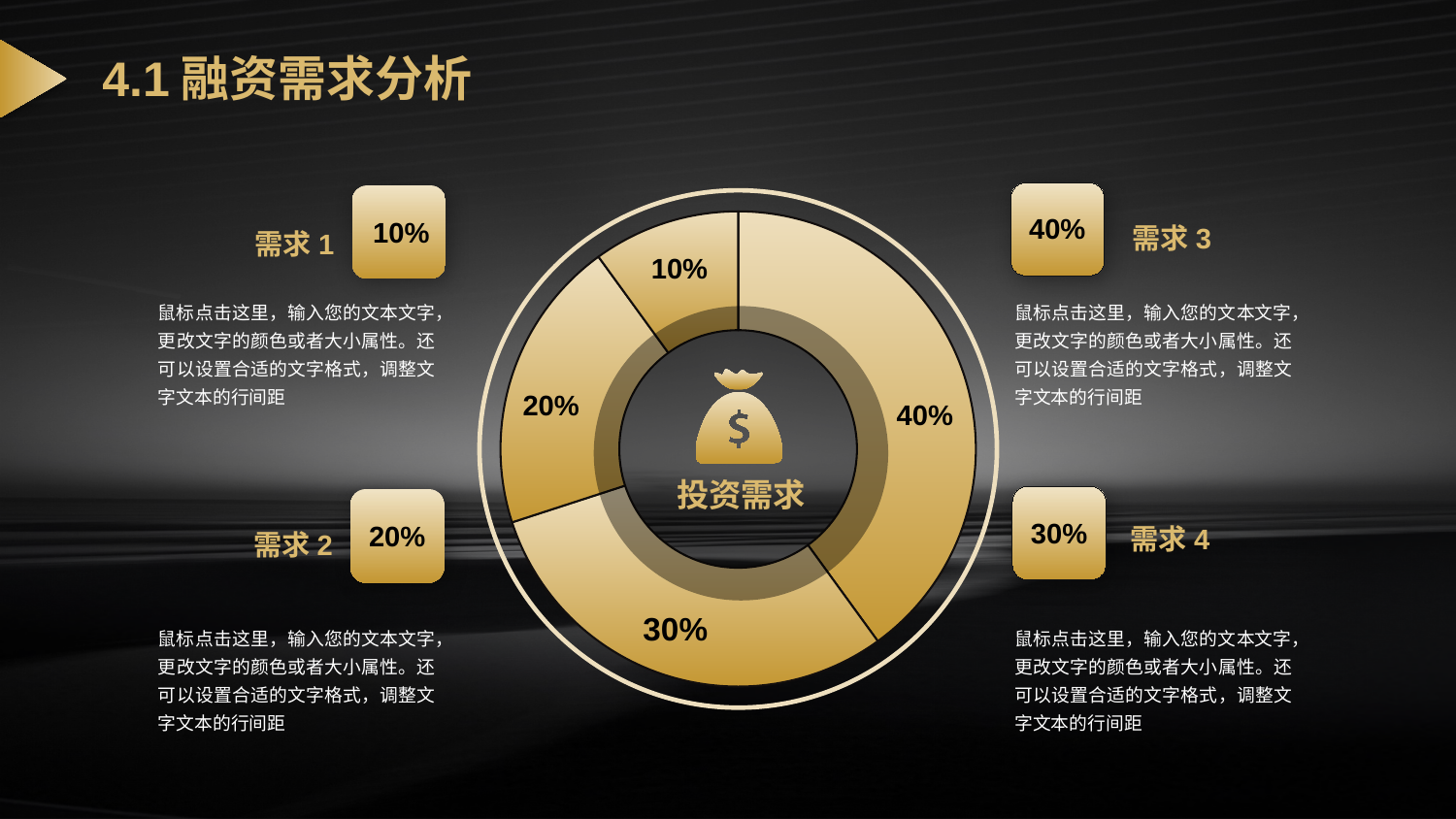
What is the difference between the values for 需求 3 and 需求 2? 20% How many segments does the chart have? 4 What type of chart is shown on the slide? Donut (pie) chart What is the title of the slide containing the chart? 4.1 融资需求分析 Which is larger, the value for 需求 4 or the value for 需求 2? 需求 4 Which category has the largest share of the chart? 需求 3 What is the value for 需求 2? 20% What text is shown in the center of the donut chart? 投资需求 Which category has the smallest share of the chart? 需求 1 What is the value for 需求 1? 10% What is the value for 需求 3? 40% What is the value for 需求 4? 30%